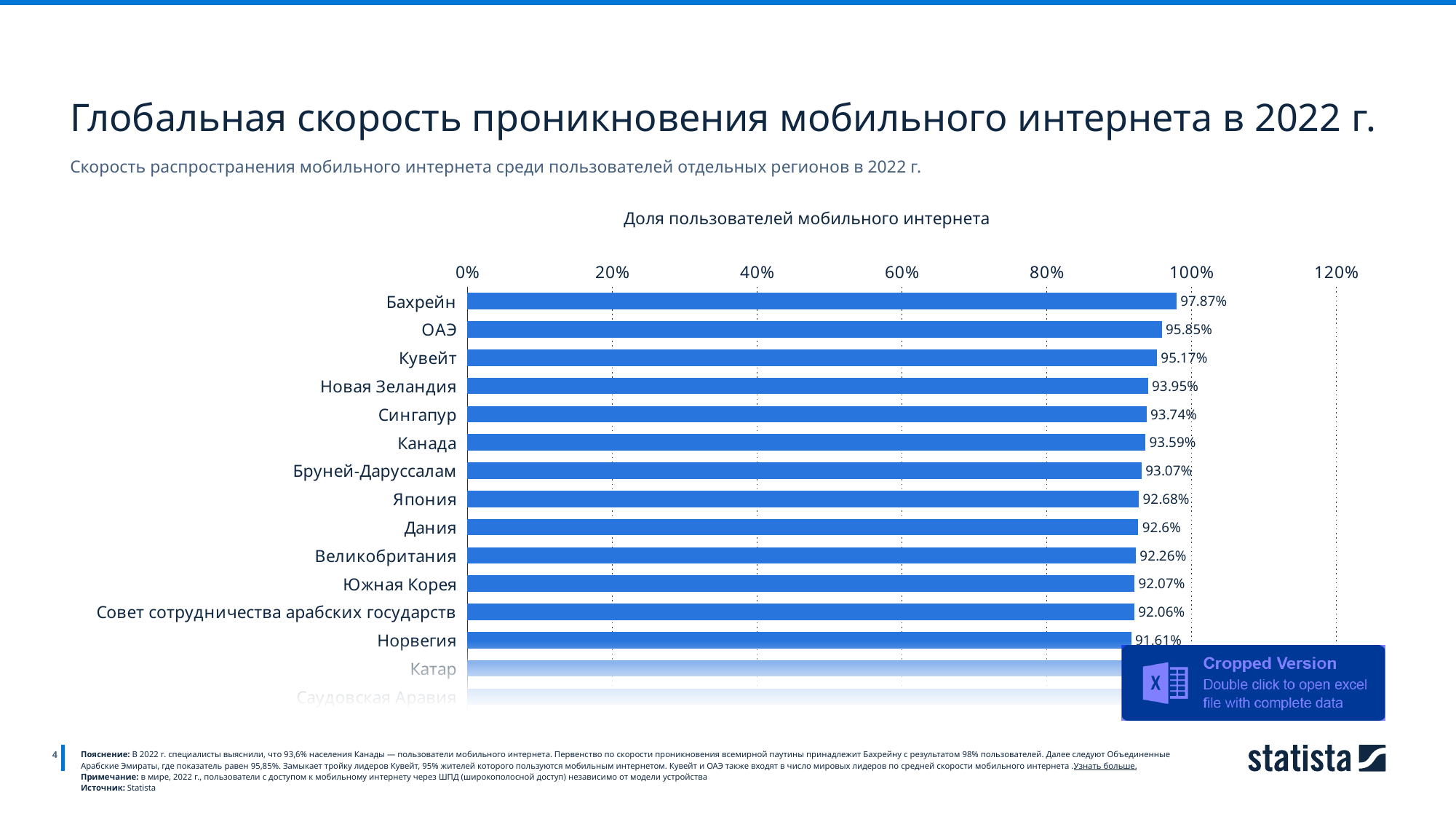
What is the value for Совет сотрудничества арабских государств? 92.06% What is the difference between the values for Бахрейн and ОАЭ? 2.02 percentage points Which is larger, the value for Кувейт or the value for Япония? Кувейт Which category has the highest value? Бахрейн What kind of chart is shown on the slide? bar chart Is the value for Бахрейн greater or less than 100%? less What is the title of the chart? Доля пользователей мобильного интернета What is the value for Канада? 93.59% What is the difference between the values for Бахрейн and Норвегия? 6.26 percentage points Is the value for Норвегия greater or less than 80%? greater What is the value for Бахрейн? 97.87% What is the value for Норвегия? 91.61%